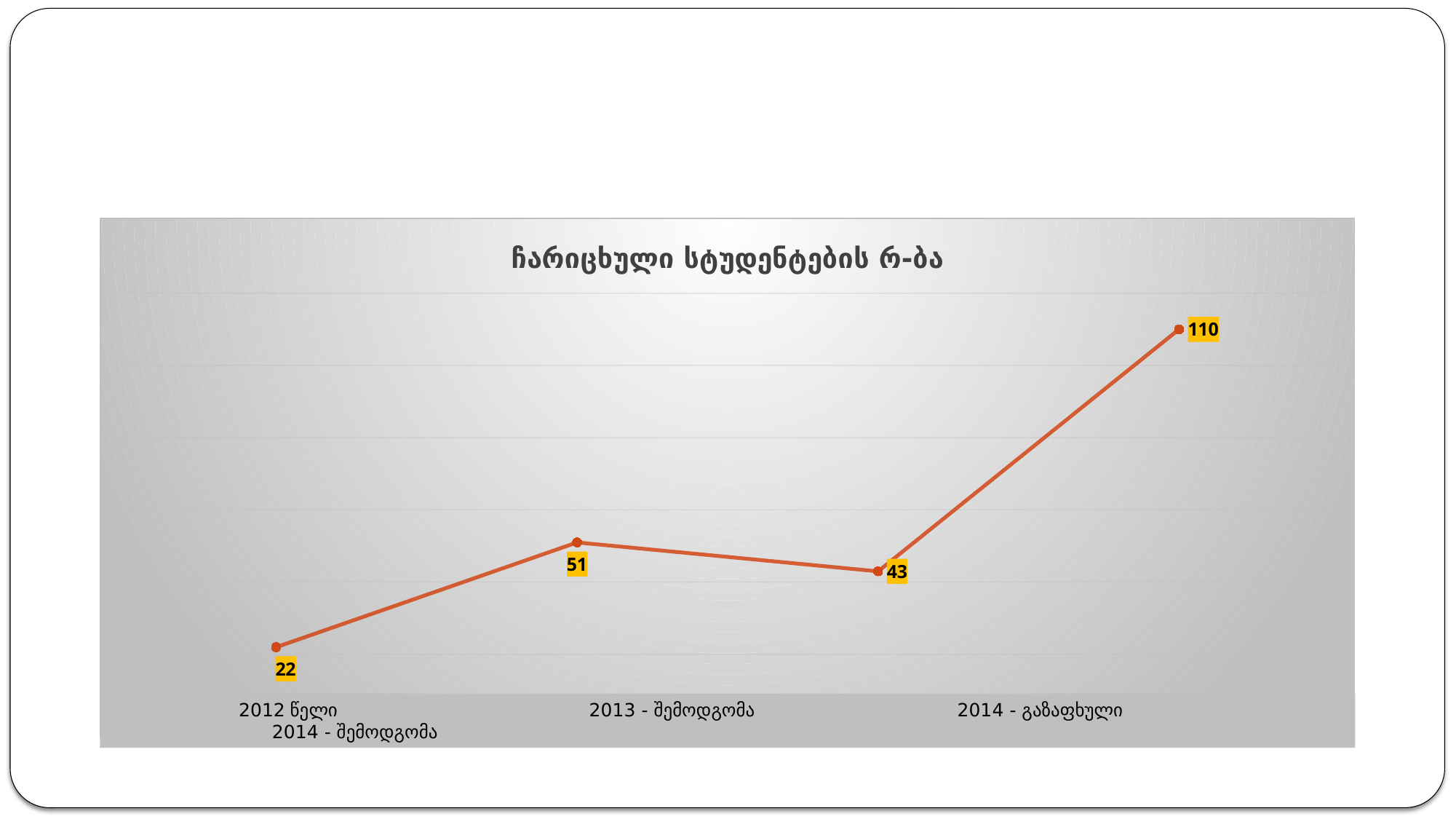
What is the difference between the highest value (110) and the lowest value (22)? 88 How many data points are plotted on the line? 4 Which is larger, the second data point (51) or the third data point (43)? 51 What type of chart is shown on the slide? line chart What is the value of the first data point (2012 წელი)? 22 What is the highest value plotted on the chart? 110 What is the lowest value plotted on the chart? 22 What is the value of the last data point on the line? 110 Does the line rise or fall between the third and the last data point? rise What is the title of the chart? ჩარიცხული სტუდენტების რ-ბა What is the value of the second data point on the line? 51 What is the value of the third data point on the line? 43